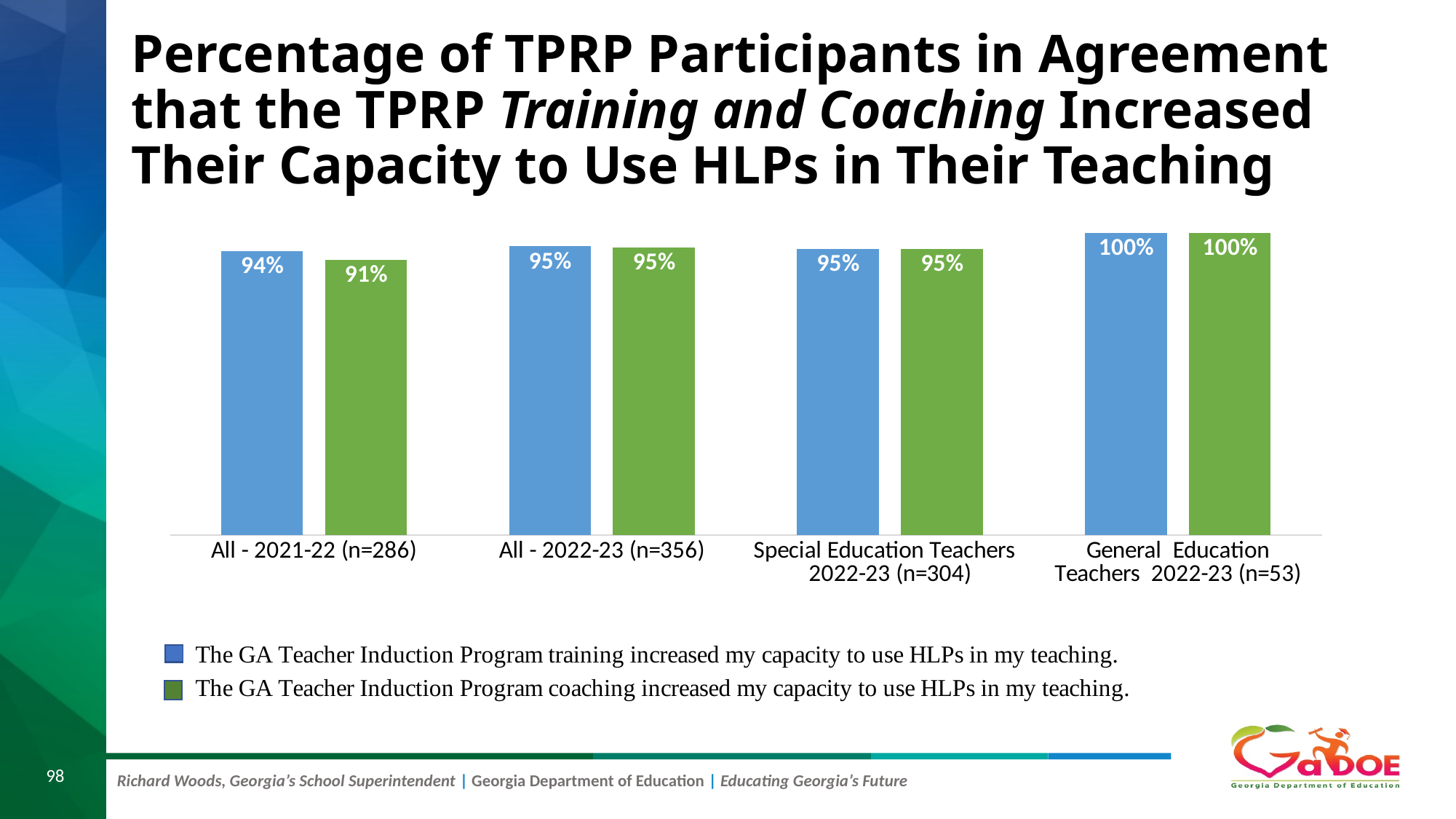
What percentage of All - 2021-22 (n=286) participants agreed that the coaching increased their capacity to use HLPs? 91% Which category has the highest value for the training series? General Education Teachers 2022-23 (n=53) Which category has the lowest value for the coaching series? All - 2021-22 (n=286) What colour are the bars for the coaching series? green How many categories are shown on the x axis? 4 For All - 2021-22 (n=286), which is larger: the training value or the coaching value? training What percentage of All - 2021-22 (n=286) participants agreed that the training increased their capacity to use HLPs? 94% What is the difference between the training and coaching values for All - 2021-22 (n=286)? 3% What is the training value for Special Education Teachers 2022-23 (n=304)? 95% How many series does the legend list? 2 What kind of chart is shown on the slide? bar chart What is the coaching value for General Education Teachers 2022-23 (n=53)? 100%